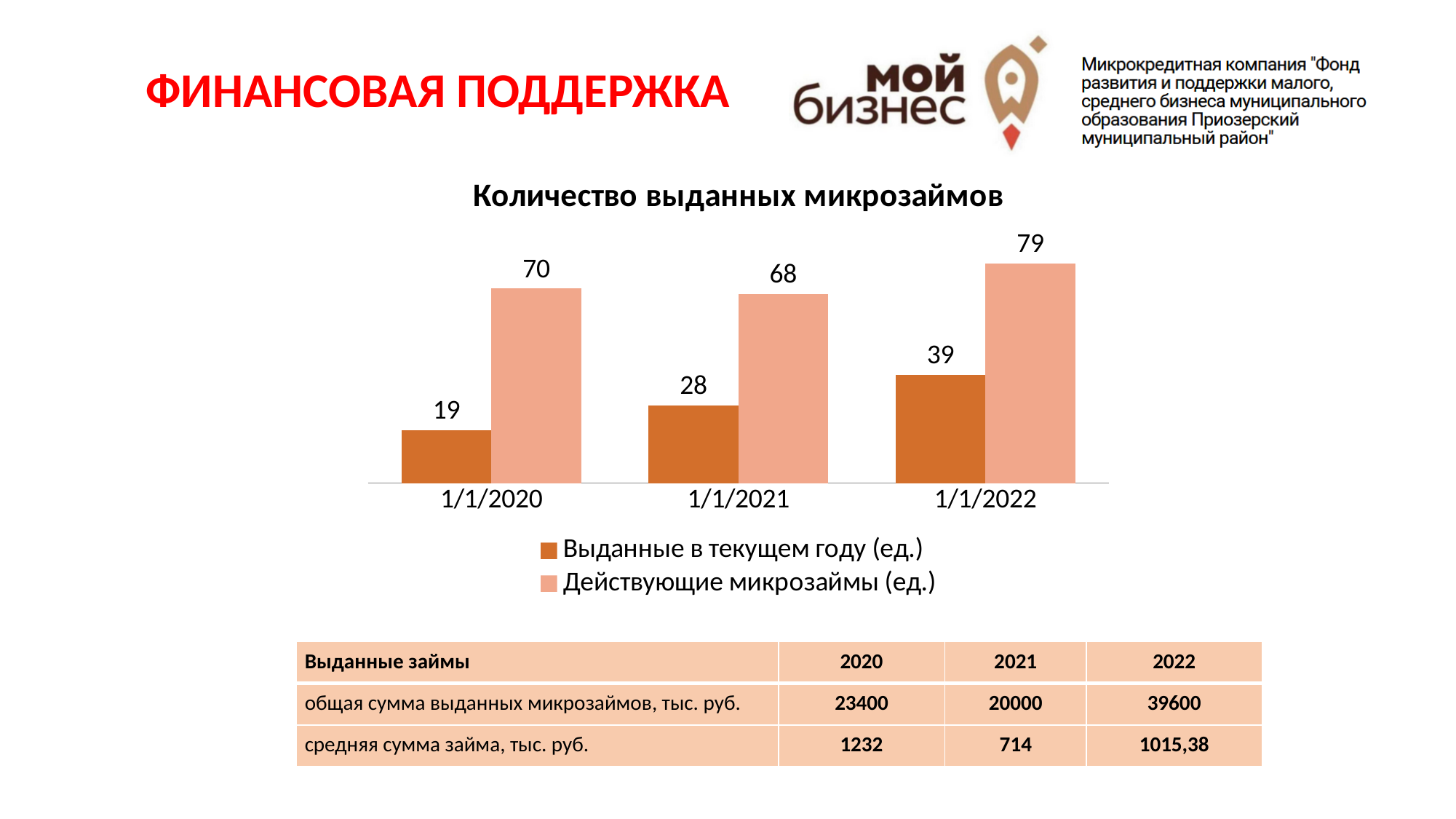
How many dates are shown on the x axis of the chart? 3 What is the value for 'Действующие микрозаймы (ед.)' at 1/1/2022? 79 What is the difference between 'Действующие микрозаймы (ед.)' and 'Выданные в текущем году (ед.)' at 1/1/2022? 40 What is the title of the chart? Количество выданных микрозаймов What kind of chart is shown on the slide? bar chart Do the values for 'Выданные в текущем году (ед.)' rise or fall from 1/1/2020 to 1/1/2022? rise Which is larger: 'Выданные в текущем году (ед.)' at 1/1/2021 or at 1/1/2020? 1/1/2021 Which date has the lowest value for 'Действующие микрозаймы (ед.)'? 1/1/2021 What is the value for 'Выданные в текущем году (ед.)' at 1/1/2020? 19 How many series does the chart legend list? 2 Which date has the highest value for 'Выданные в текущем году (ед.)'? 1/1/2022 What is the value for 'Действующие микрозаймы (ед.)' at 1/1/2021? 68